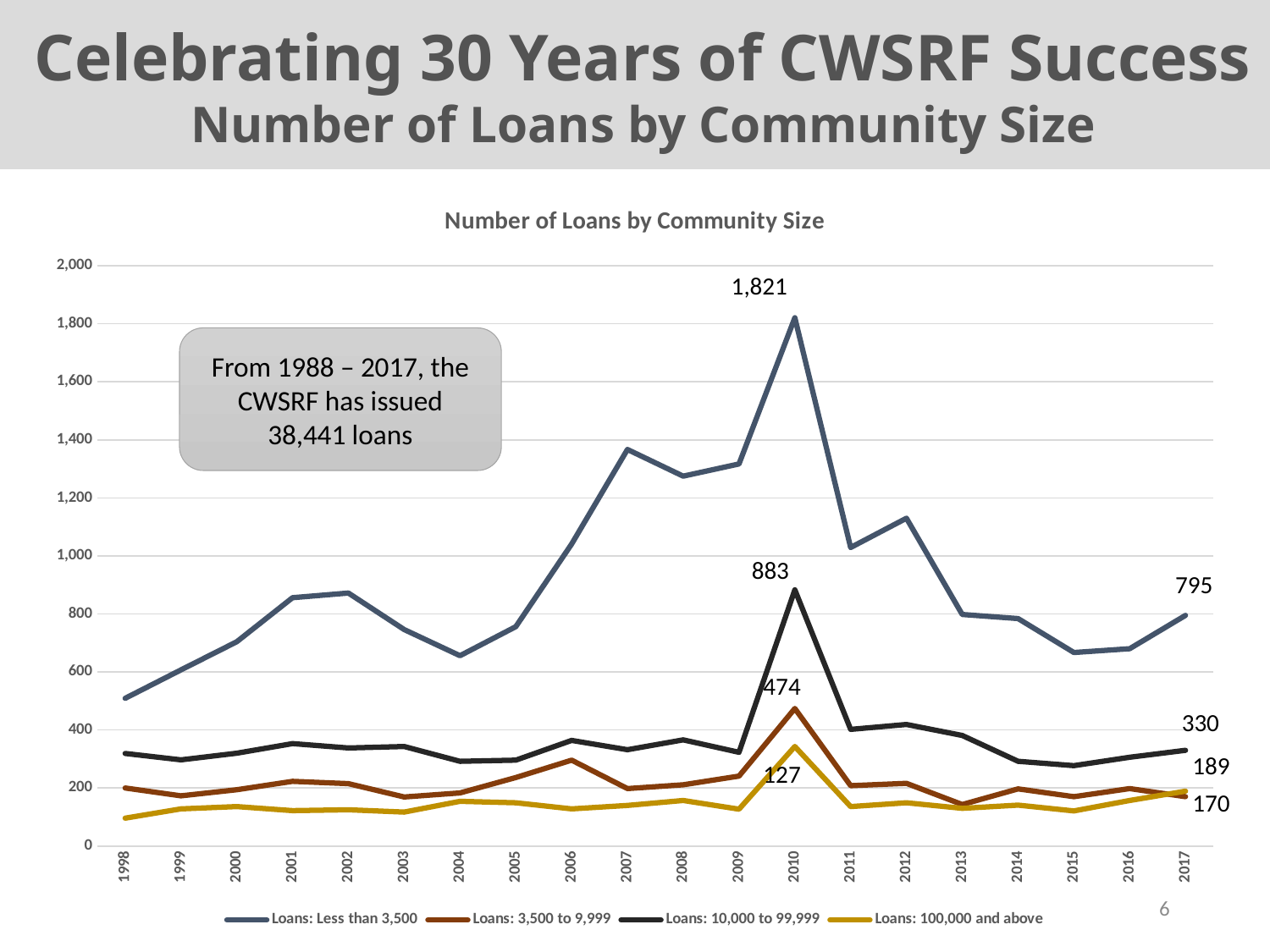
What is the title of the chart? Number of Loans by Community Size What is the number of loans for communities of less than 3,500 in 2010? 1,821 What is the difference between the 2010 values for communities of less than 3,500 and communities of 10,000 to 99,999? 938 How many series does the legend list? 4 What is the number of loans for communities of 10,000 to 99,999 in 2010? 883 What is the number of loans for communities of 3,500 to 9,999 in 2010? 474 Is the value for 'Loans: Less than 3,500' in 1998 greater or less than 600? less In which year does the 'Loans: Less than 3,500' series reach its highest value? 2010 How many years are shown along the x axis? 20 What kind of chart is shown on the slide? Line chart What is the number of loans for communities of less than 3,500 in 2017? 795